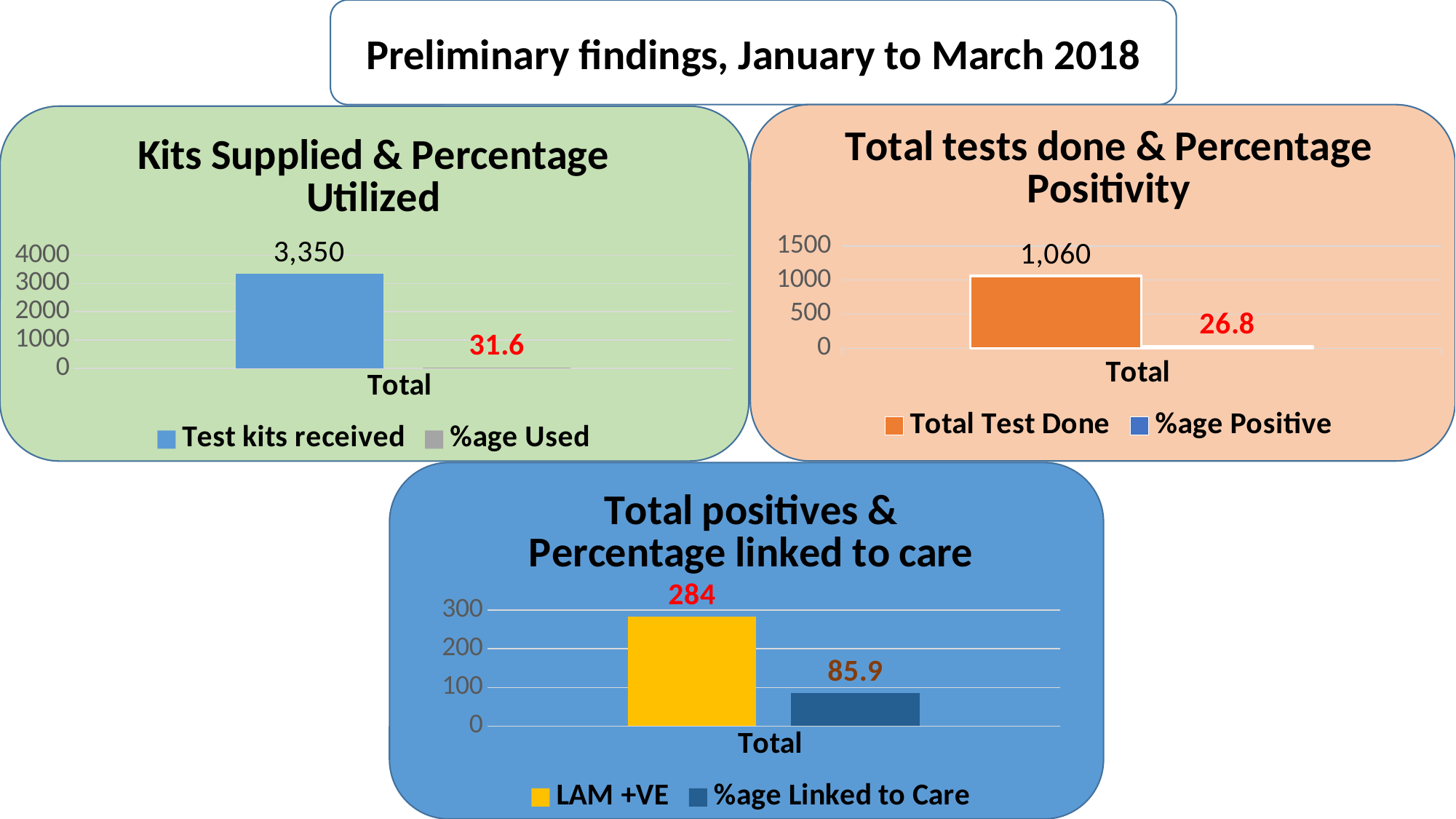
What kind of chart is the 'Kits Supplied & Percentage Utilized' chart? Bar chart What colour is the LAM +VE bar in the 'Total positives & Percentage linked to care' chart? Yellow In the 'Total tests done & Percentage Positivity' chart, what is the value for %age Positive? 26.8 In the 'Total positives & Percentage linked to care' chart, what is the difference between the LAM +VE value and the %age Linked to Care value? 198.1 How many series does the legend of the 'Total tests done & Percentage Positivity' chart list? 2 In the 'Total tests done & Percentage Positivity' chart, is the value for Total Test Done greater or less than 1000? greater In the 'Total positives & Percentage linked to care' chart, what is the value for %age Linked to Care? 85.9 In the 'Kits Supplied & Percentage Utilized' chart, what is the value for %age Used? 31.6 In the 'Total positives & Percentage linked to care' chart, what is the value for LAM +VE? 284 In the 'Kits Supplied & Percentage Utilized' chart, what is the value for Test kits received? 3,350 In the 'Total tests done & Percentage Positivity' chart, what is the value for Total Test Done? 1,060 In the 'Total positives & Percentage linked to care' chart, which series has the larger value, LAM +VE or %age Linked to Care? LAM +VE